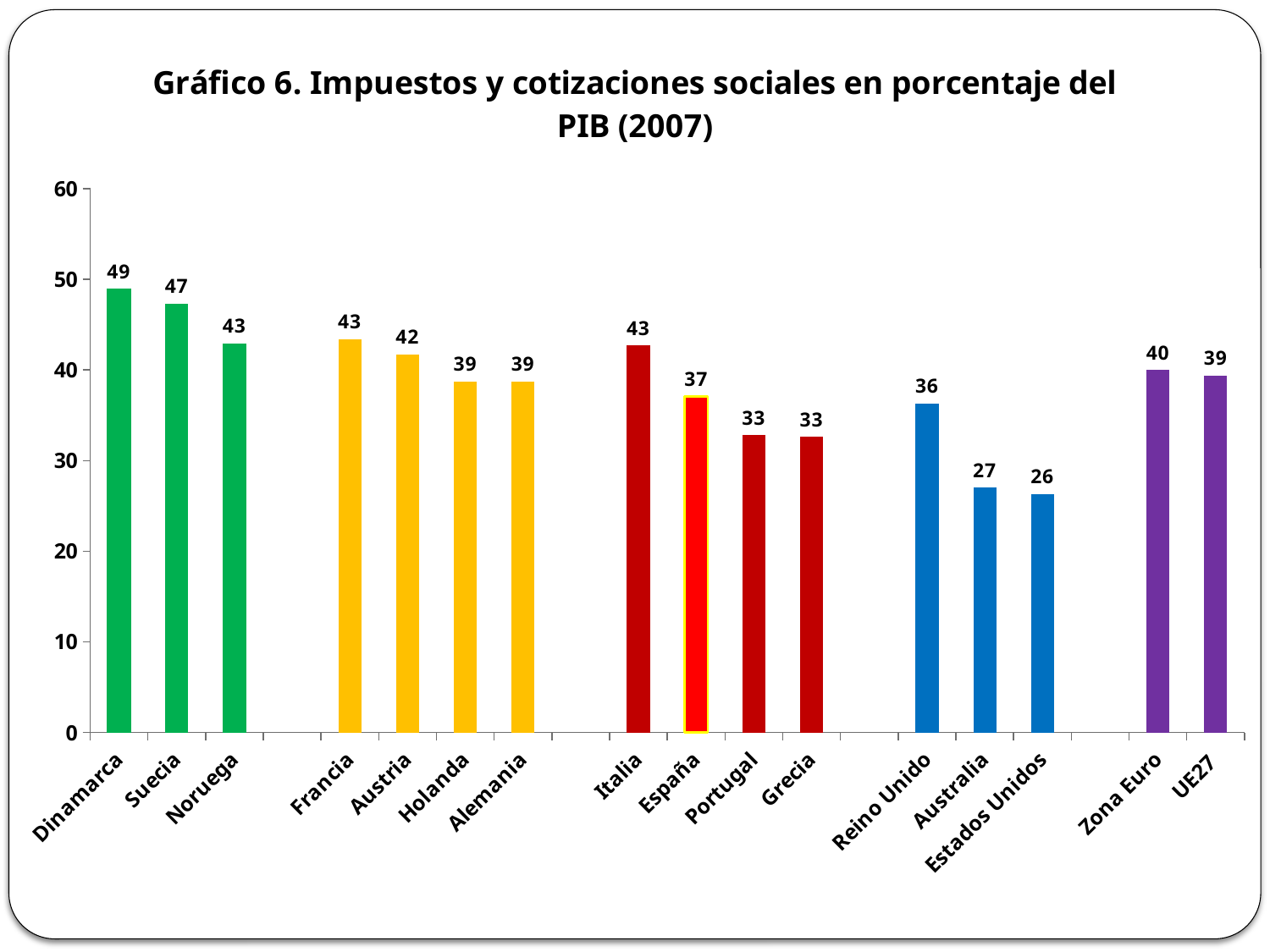
What is the difference between the values for Francia and España? 6 Which country has the highest value? Dinamarca Which is larger, the value for Suecia or the value for Italia? Suecia What is the title of the chart? Gráfico 6. Impuestos y cotizaciones sociales en porcentaje del PIB (2007) What is the value for Reino Unido? 36 What is the value for España? 37 Is the value for Australia greater or less than 30? less What is the value for Zona Euro? 40 Which country has the lowest value? Estados Unidos What kind of chart is shown on the slide? bar chart How many bars are shown in the chart? 16 What is the difference between the values for Dinamarca and Estados Unidos? 23